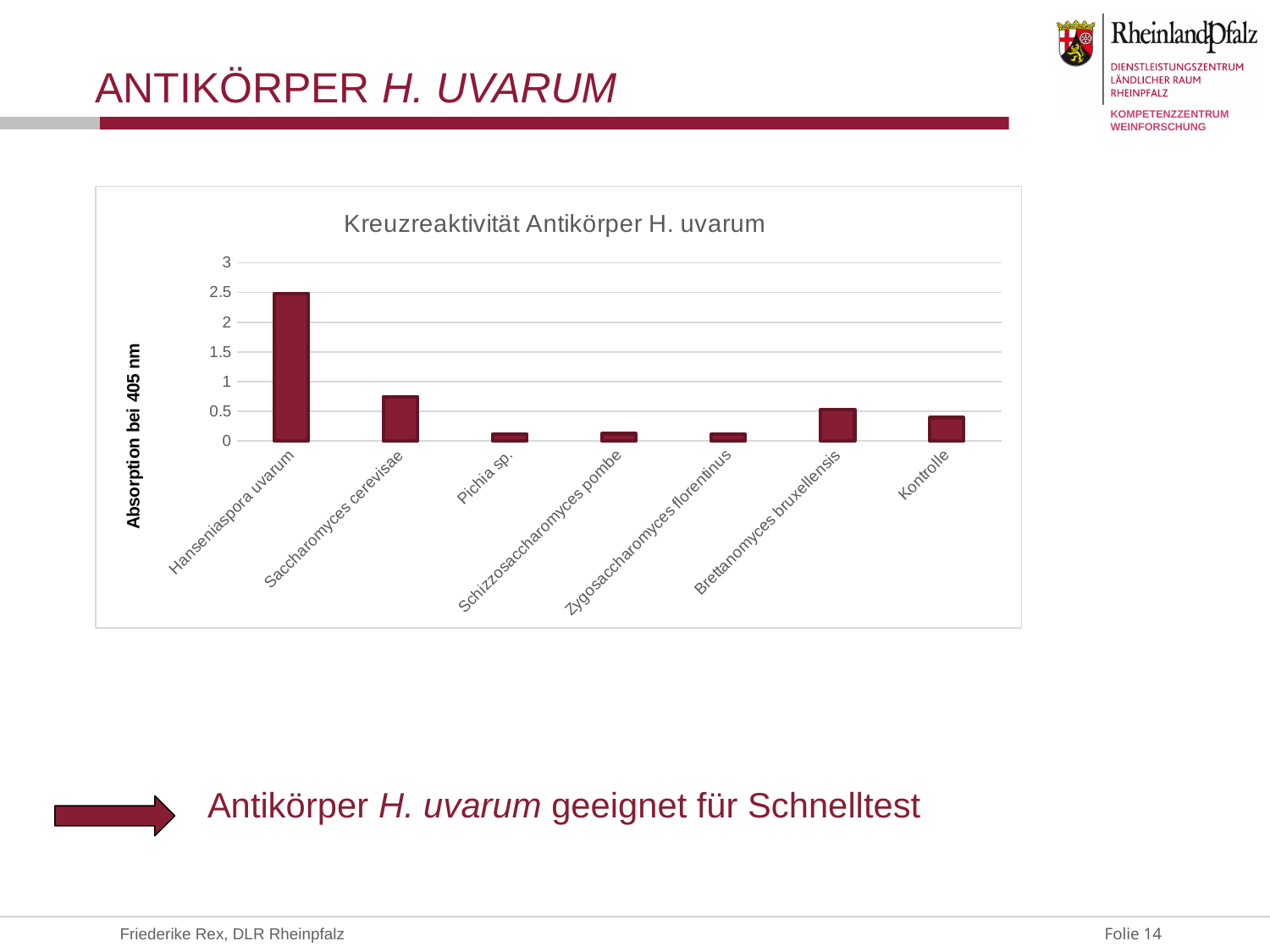
Is the value for Saccharomyces cerevisiae greater or less than 0.5? greater What is the label of the vertical axis? Absorption bei 405 nm Which has a larger value, Saccharomyces cerevisiae or Kontrolle? Saccharomyces cerevisiae Is the value for Brettanomyces bruxellensis greater or less than 1? less Is the value for Kontrolle greater or less than 0.5? less What type of chart is shown on the slide? bar chart What is the title of the chart? Kreuzreaktivität Antikörper H. uvarum Which has a larger value, Hanseniaspora uvarum or Brettanomyces bruxellensis? Hanseniaspora uvarum How many categories are shown on the x axis of the chart? 7 Which category has the highest absorption value? Hanseniaspora uvarum